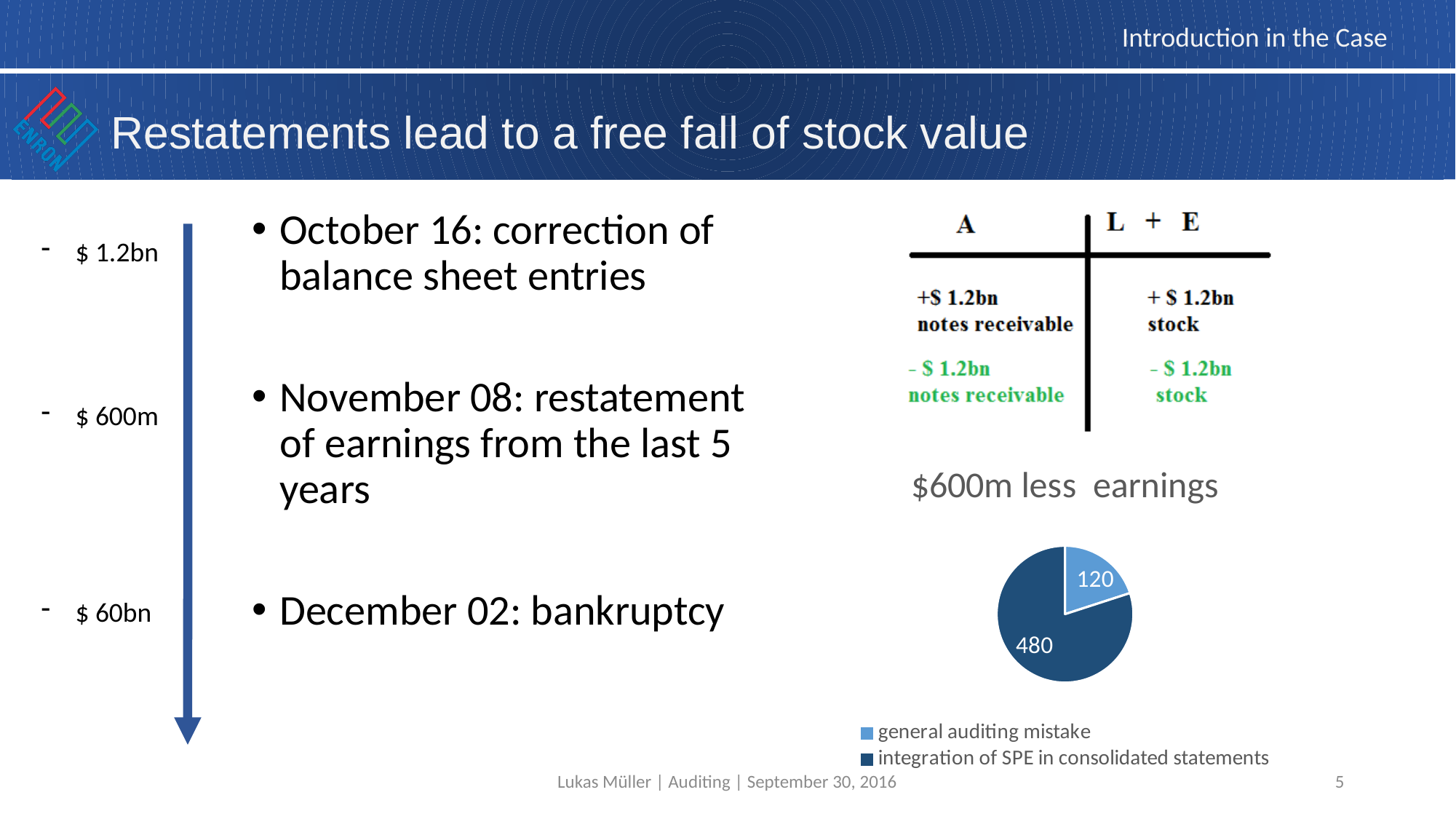
Which slice of the pie chart is the smallest? general auditing mistake What is the total of the two slices in the pie chart? 600 How many entries does the pie chart legend list? 2 What share of the pie chart does the 'general auditing mistake' slice represent? 20% Which is larger in the pie chart: 'general auditing mistake' or 'integration of SPE in consolidated statements'? integration of SPE in consolidated statements What is the value of the 'integration of SPE in consolidated statements' slice in the pie chart? 480 What is the value of the 'general auditing mistake' slice in the pie chart? 120 What colour is the 'integration of SPE in consolidated statements' slice in the pie chart? dark blue What is the difference between the 'integration of SPE in consolidated statements' slice and the 'general auditing mistake' slice? 360 How many slices does the pie chart have? 2 What kind of chart is shown on the slide? pie chart Which slice of the pie chart is the largest? integration of SPE in consolidated statements